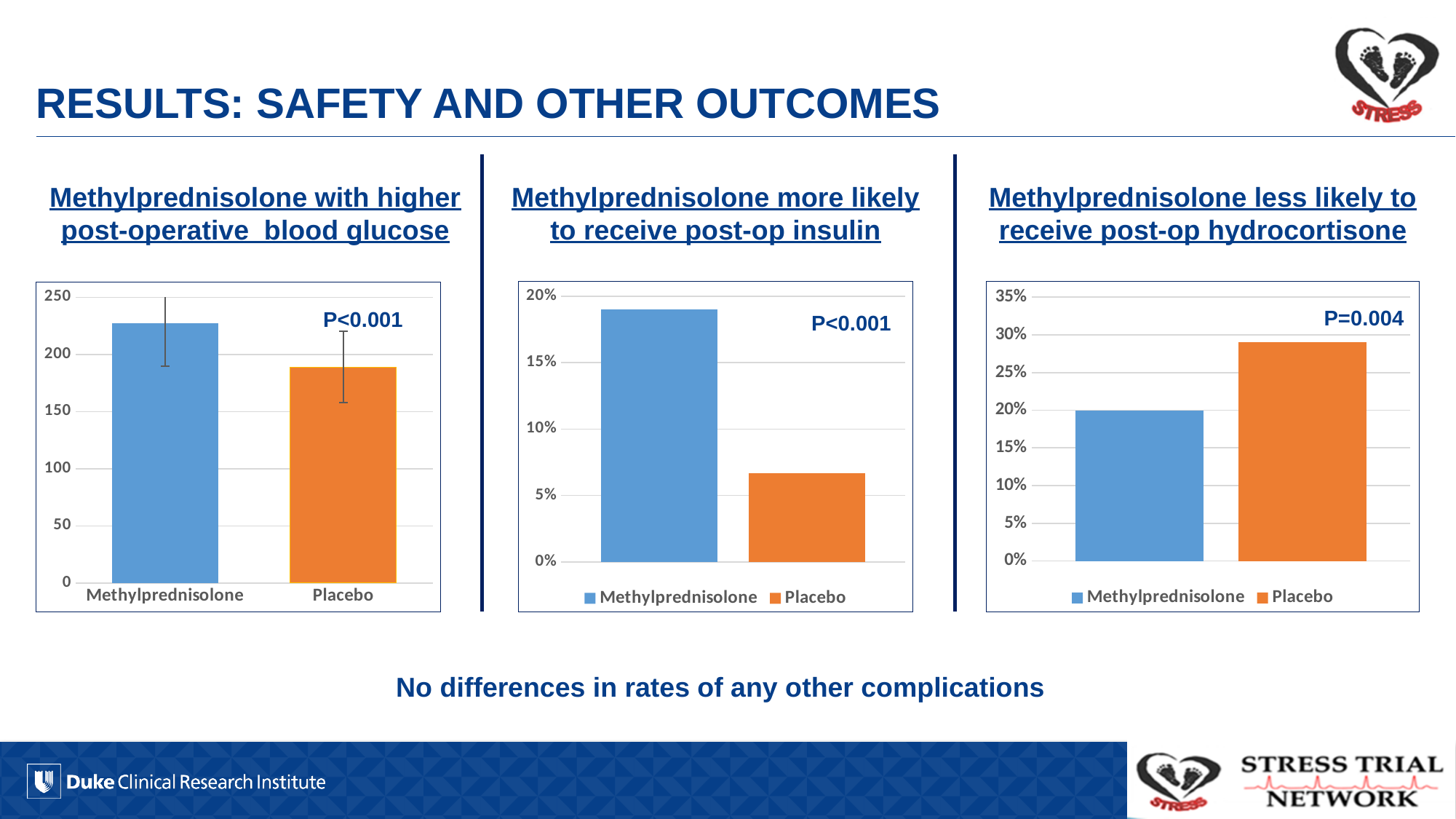
In the left chart (post-operative blood glucose), is the value for Placebo greater or less than 200? less In the left chart (post-operative blood glucose), which group has the higher value? Methylprednisolone What P-value is shown on the right chart (post-op hydrocortisone)? P=0.004 In the middle chart (post-op insulin), is the value for Methylprednisolone greater or less than 15%? greater In the right chart (post-op hydrocortisone), is the value for Placebo greater or less than 25%? greater How many series does the legend of the middle chart (post-op insulin) list? 2 What kind of chart is the left chart (post-operative blood glucose)? bar chart In the middle chart (post-op insulin), which group has the lower value? Placebo In the right chart (post-op hydrocortisone), which group has the higher value, Methylprednisolone or Placebo? Placebo